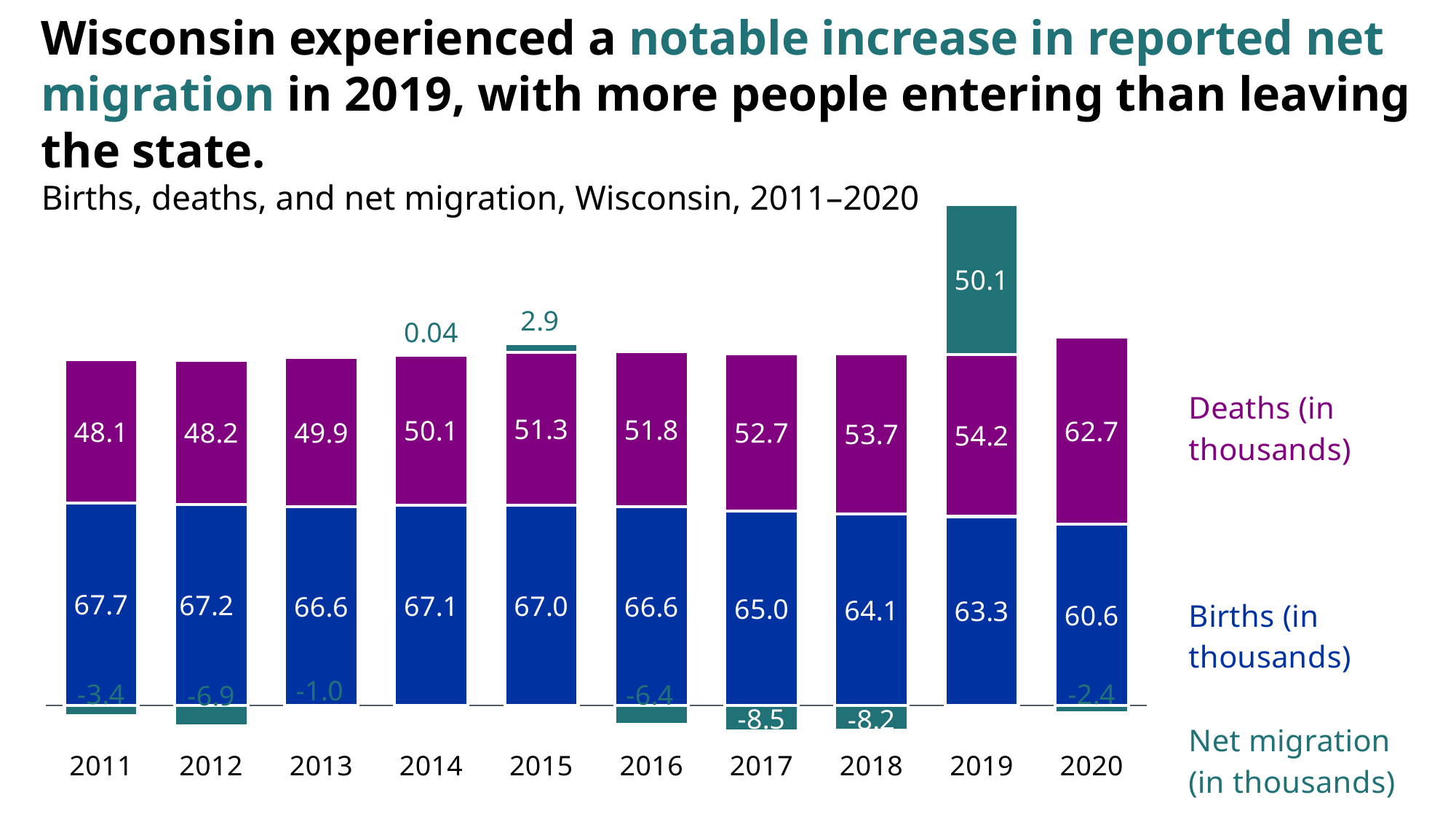
Which year has the highest value for Deaths (in thousands)? 2020 Which is larger, Deaths (in thousands) in 2014 or in 2015? 2015 How many years are shown on the x axis? 10 Which year has the lowest value for Births (in thousands)? 2020 What is the value for Net migration (in thousands) in 2017? -8.5 What kind of chart is shown on the slide? Stacked bar chart Do the values for Births (in thousands) generally rise or fall from 2011 to 2020? Fall What is the value for Net migration (in thousands) in 2019? 50.1 How many series does the legend list? 3 What is the difference between Deaths (in thousands) in 2020 and in 2019? 8.5 What is the value for Births (in thousands) in 2015? 67.0 What is the value for Deaths (in thousands) in 2020? 62.7